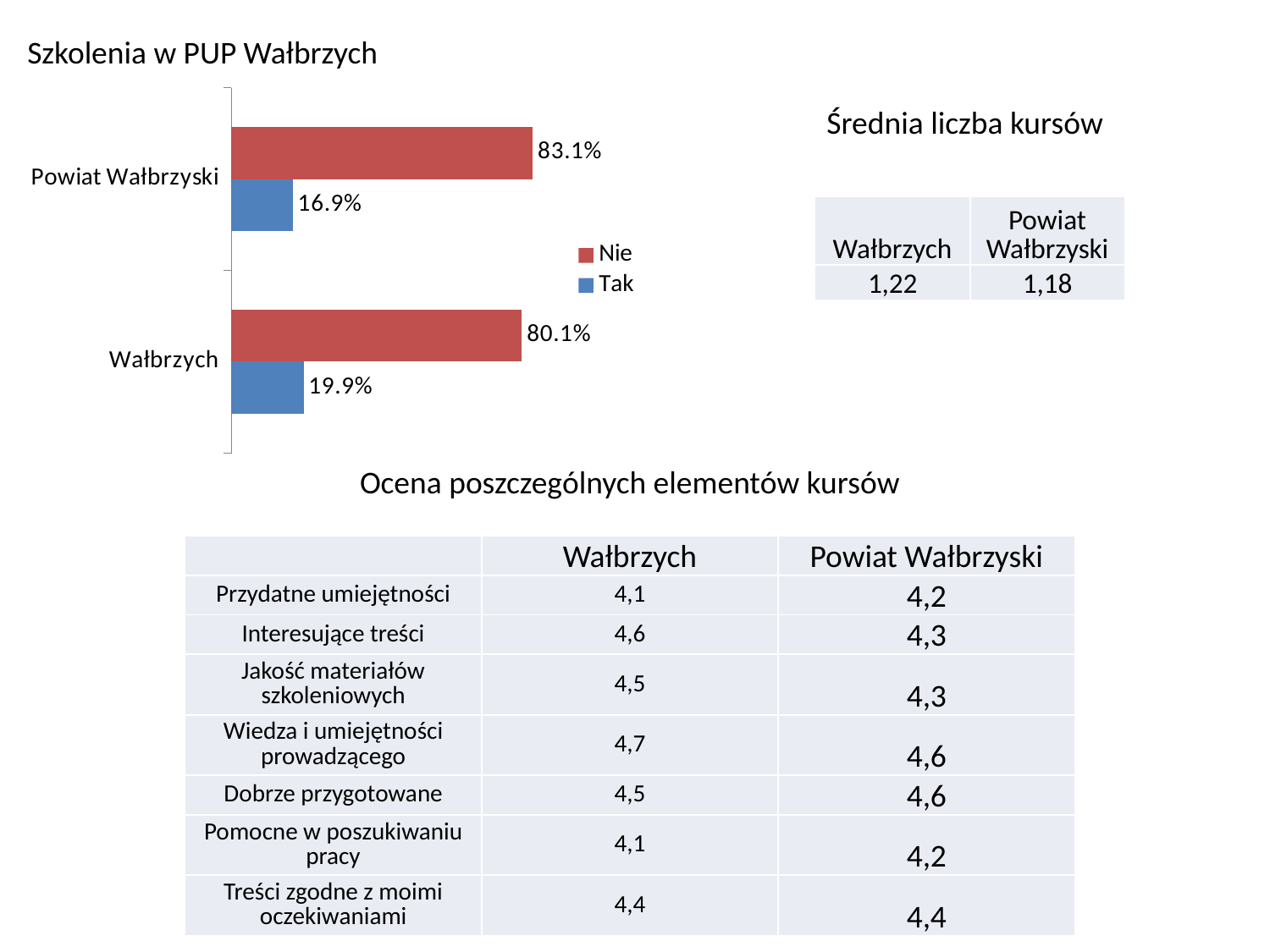
What is the value of the "Tak" bar for Wałbrzych? 19.9% What is the value of the "Nie" bar for Powiat Wałbrzyski? 83.1% How many categories are shown on the chart? 2 Which category has the higher "Tak" value, Powiat Wałbrzyski or Wałbrzych? Wałbrzych Which category has the higher "Nie" value, Powiat Wałbrzyski or Wałbrzych? Powiat Wałbrzyski What is the value of the "Tak" bar for Powiat Wałbrzyski? 16.9% What is the difference between the "Nie" and "Tak" values for Wałbrzych? 60.2% Which series is shown in red in the chart legend? Nie What is the value of the "Nie" bar for Wałbrzych? 80.1% How many series does the chart legend list? 2 What kind of chart is shown on the slide? Bar chart What is the difference between the "Tak" values for Wałbrzych and Powiat Wałbrzyski? 3.0%